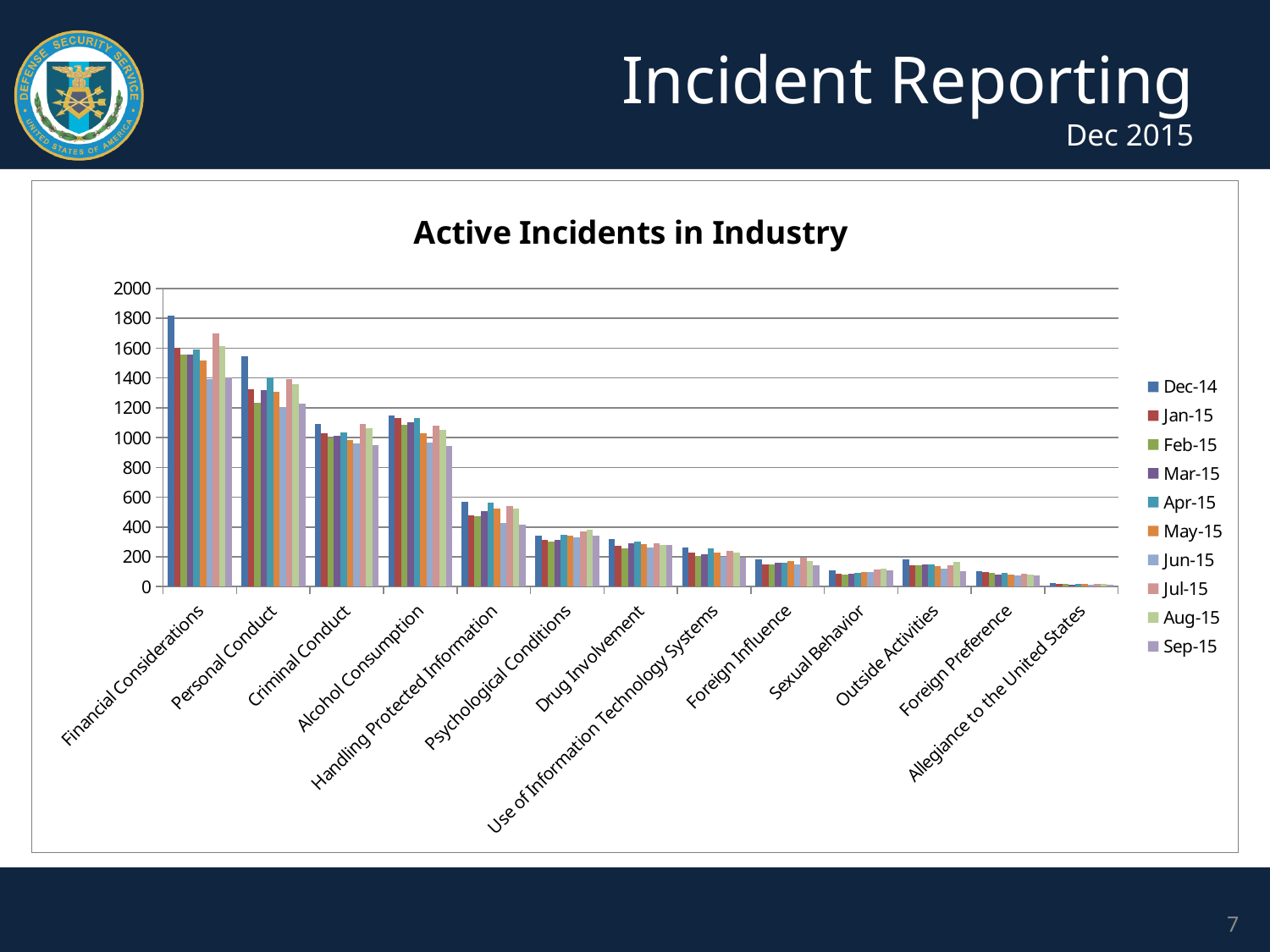
For Dec-14, which is larger: Alcohol Consumption or Handling Protected Information? Alcohol Consumption Is the Dec-14 value for Criminal Conduct greater or less than 1000? greater Which category has the highest bars in the chart? Financial Considerations How many series does the legend list? 10 What kind of chart is shown on the slide? bar chart Is the Dec-14 value for Psychological Conditions greater or less than 400? less Moving from left to right across the categories, do the bar heights generally rise or fall? fall Which category has the lowest bars in the chart? Allegiance to the United States Is the Dec-14 value for Sexual Behavior greater or less than 200? less What is the title of the chart? Active Incidents in Industry How many categories are shown along the x axis of the chart? 13